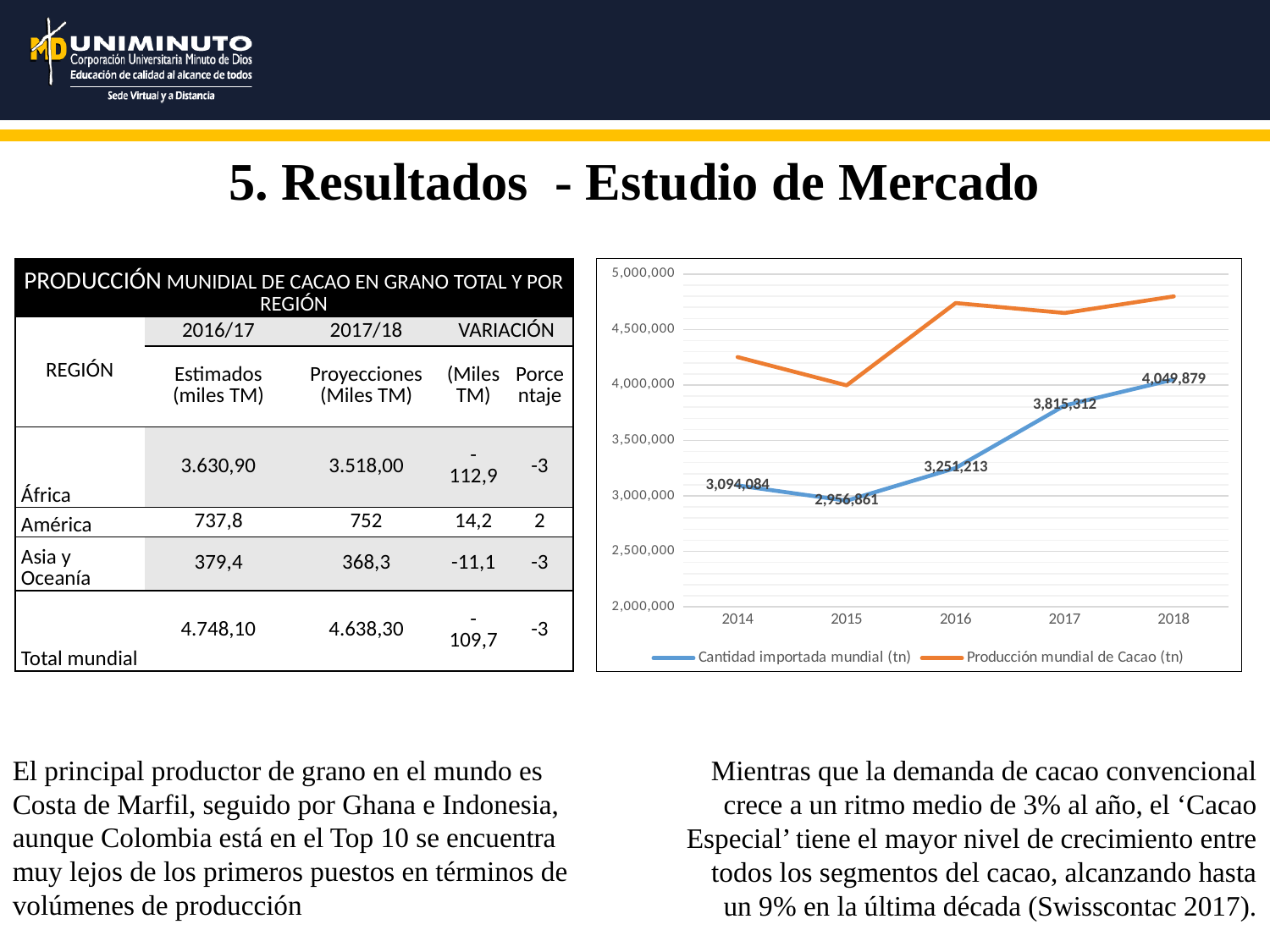
Does Cantidad importada mundial (tn) rise or fall from 2015 to 2018? rise What type of chart is shown on the slide? line chart How many series does the chart legend list? 2 In which year is Cantidad importada mundial (tn) highest? 2018 Is the value of Producción mundial de Cacao (tn) in 2016 greater or less than 4,500,000? greater What colour is the line for Producción mundial de Cacao (tn)? orange In which year is Cantidad importada mundial (tn) lowest? 2015 How many years are plotted along the x axis of the chart? 5 What is the value of Cantidad importada mundial (tn) in 2014? 3,094,084 What is the difference between Cantidad importada mundial (tn) in 2018 and in 2017? 234,567 Which series has the higher value in 2016, Cantidad importada mundial (tn) or Producción mundial de Cacao (tn)? Producción mundial de Cacao (tn) What is the value of Cantidad importada mundial (tn) in 2018? 4,049,879